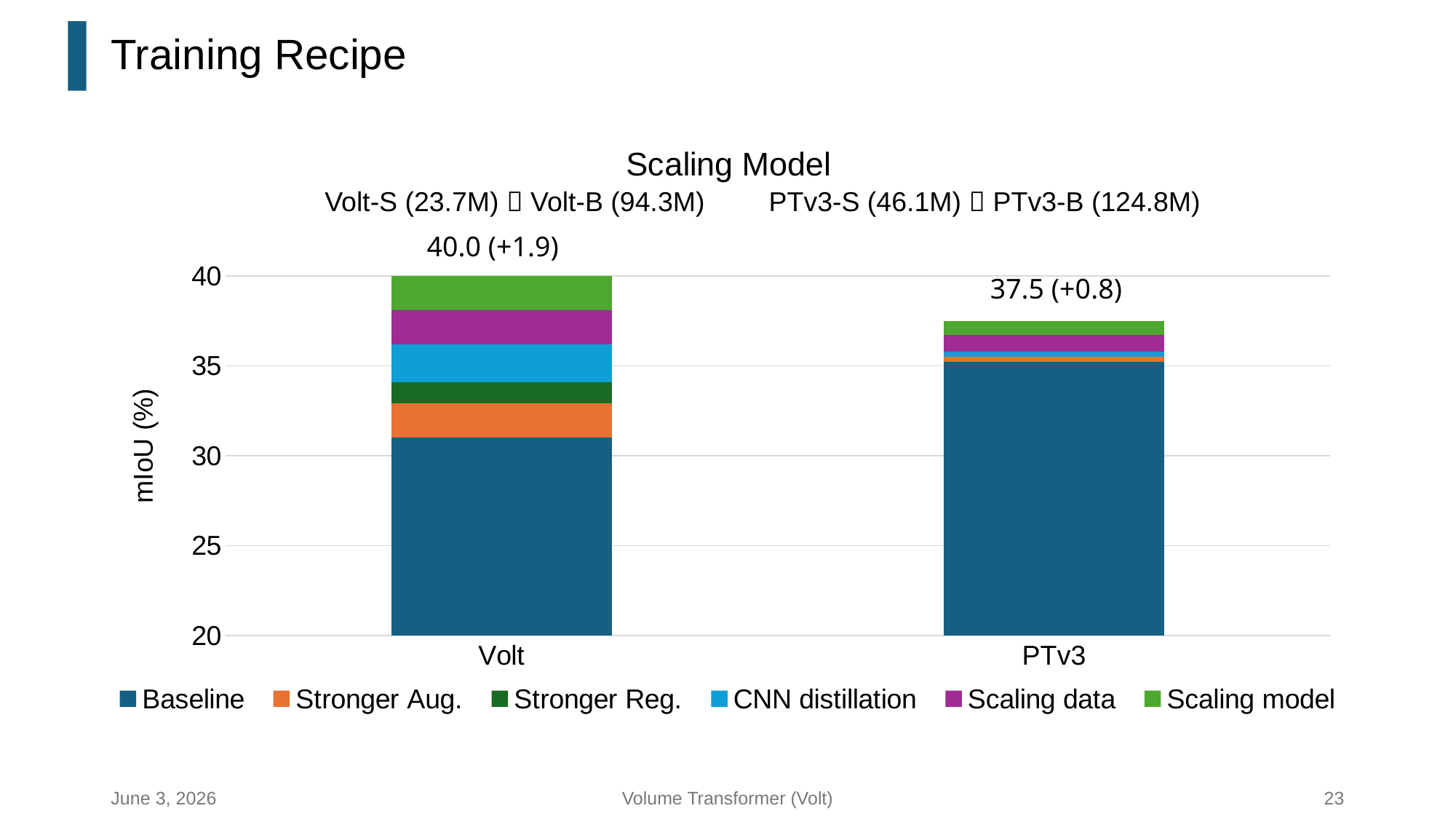
How many series does the legend list? 6 What is the total mIoU value labeled for the PTv3 bar? 37.5 What is the difference between the total mIoU of Volt and PTv3? 2.5 What kind of chart is shown on the slide? Stacked bar chart Which category has the higher total mIoU, Volt or PTv3? Volt Is the Baseline value for Volt greater or less than 35? less How many categories are shown on the x axis? 2 What gain from scaling the model is shown in the label above the Volt bar? +1.9 What gain from scaling the model is shown in the label above the PTv3 bar? +0.8 What is the title of the chart? Scaling Model What is the total mIoU value labeled for the Volt bar? 40.0 What is the label of the y axis? mIoU (%)